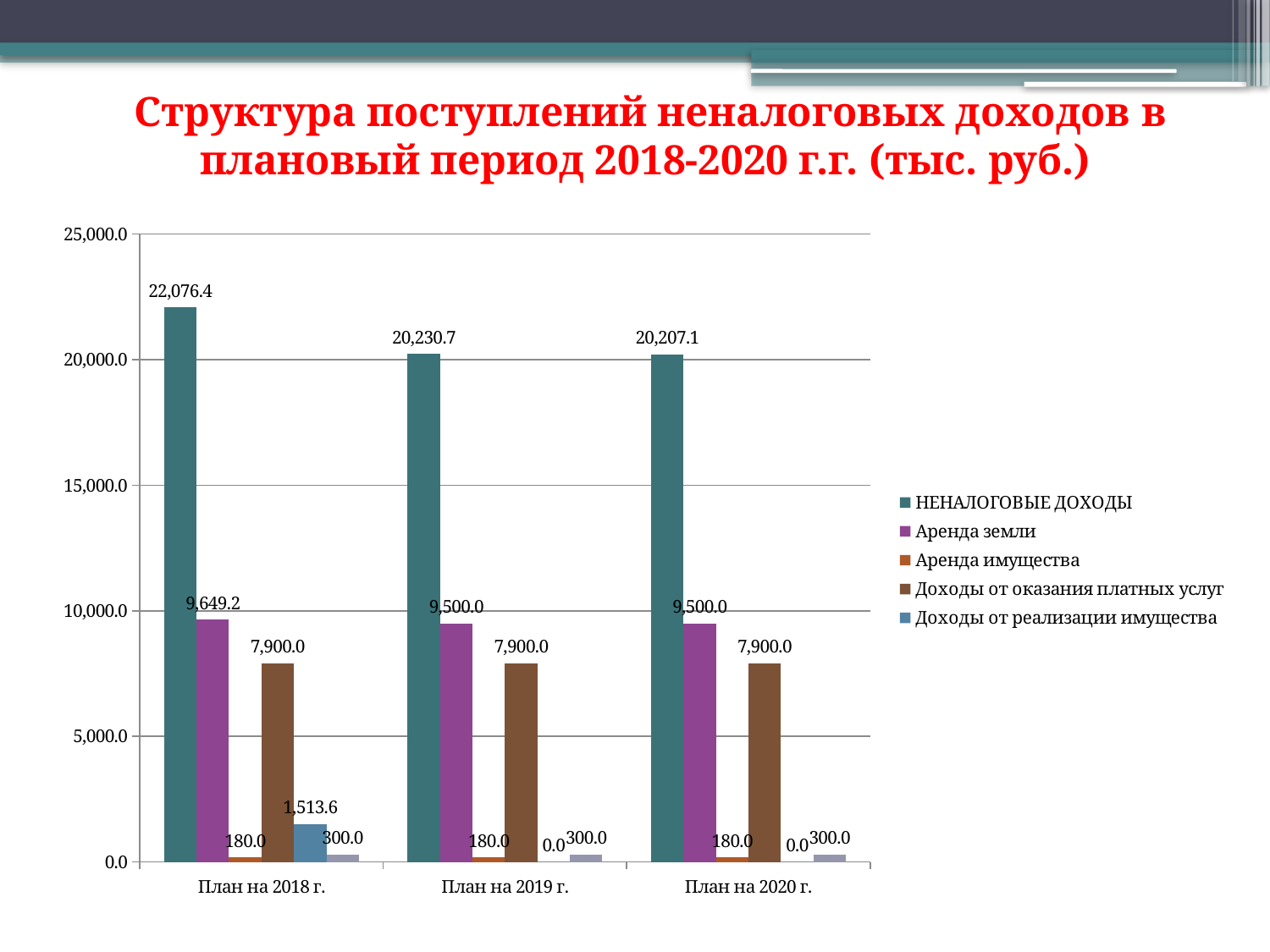
How many series does the legend list? 5 What is the difference between Аренда земли for План на 2018 г. and План на 2020 г.? 149.2 What is the difference between НЕНАЛОГОВЫЕ ДОХОДЫ for План на 2018 г. and План на 2019 г.? 1,845.7 Which is larger for План на 2019 г.: Аренда земли or Доходы от оказания платных услуг? Аренда земли What is the value of НЕНАЛОГОВЫЕ ДОХОДЫ for План на 2018 г.? 22,076.4 What is the value of Аренда земли for План на 2019 г.? 9,500.0 How many categories are shown on the x axis? 3 In which category is НЕНАЛОГОВЫЕ ДОХОДЫ highest? План на 2018 г. What is the value of Аренда имущества for План на 2020 г.? 180.0 What is the value of Доходы от реализации имущества for План на 2018 г.? 1,513.6 Does НЕНАЛОГОВЫЕ ДОХОДЫ rise or fall from План на 2018 г. to План на 2020 г.? fall What is the value of Доходы от оказания платных услуг for План на 2020 г.? 7,900.0